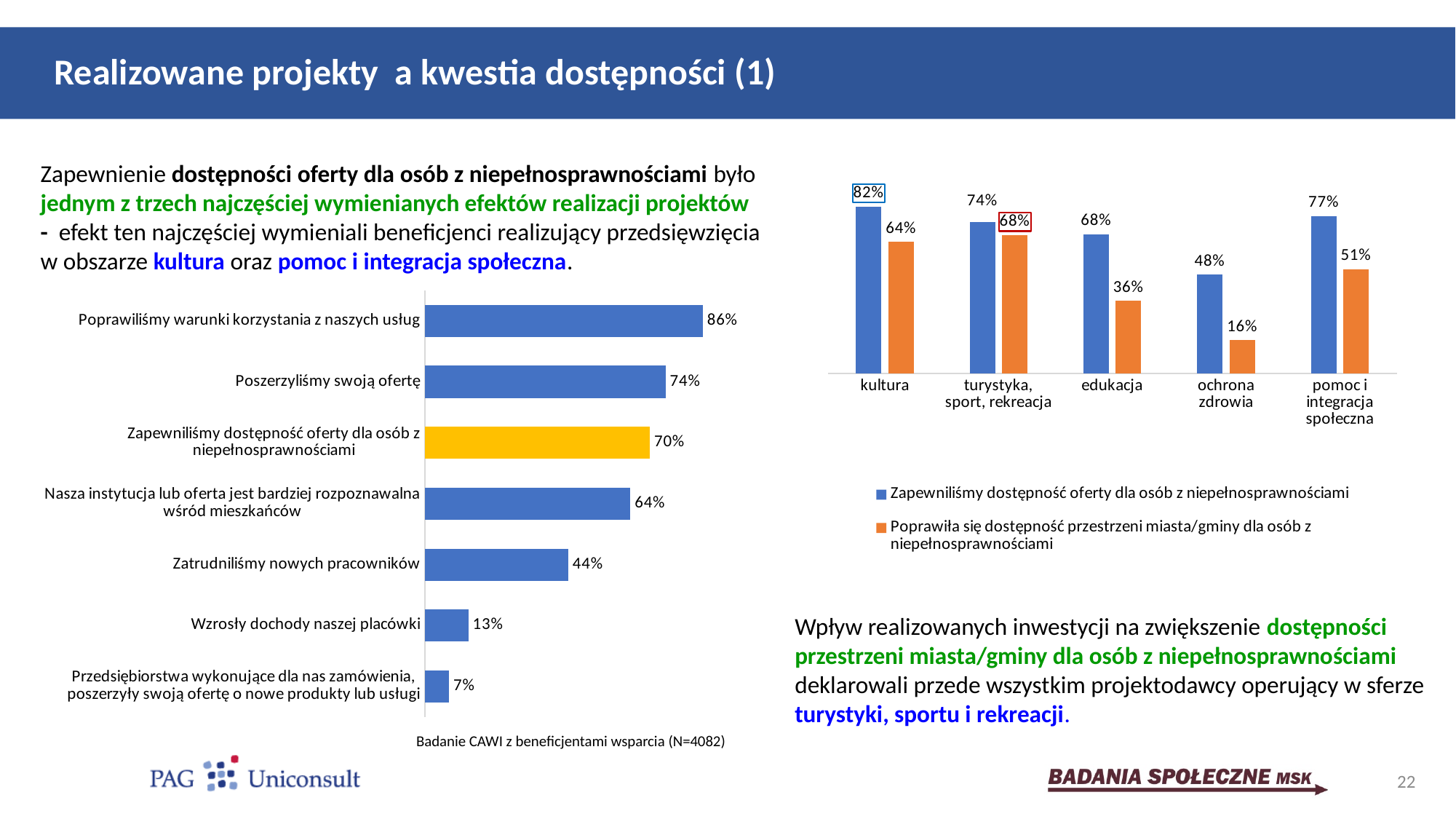
In the right chart, which is larger for "turystyka, sport, rekreacja": the blue series or the orange series? The blue series (74%) How many series does the legend of the right chart list? 2 In the left chart, what is the value for "Poszerzyliśmy swoją ofertę"? 74% In the left chart, which category has the lowest value? Przedsiębiorstwa wykonujące dla nas zamówienia, poszerzyły swoją ofertę o nowe produkty lub usługi In the right chart, what is the value of "Poprawiła się dostępność przestrzeni miasta/gminy dla osób z niepełnosprawnościami" for "ochrona zdrowia"? 16% In the right chart, which category has the highest value for "Zapewniliśmy dostępność oferty dla osób z niepełnosprawnościami"? kultura How many categories are shown in the left chart? 7 What kind of chart is the left chart? Bar chart In the left chart, which bar is coloured yellow instead of blue? Zapewniliśmy dostępność oferty dla osób z niepełnosprawnościami In the left chart, which category has the highest value? Poprawiliśmy warunki korzystania z naszych usług In the right chart, what is the difference between the two series for "edukacja"? 32% In the left chart, what is the difference between "Zatrudniliśmy nowych pracowników" and "Wzrosły dochody naszej placówki"? 31%